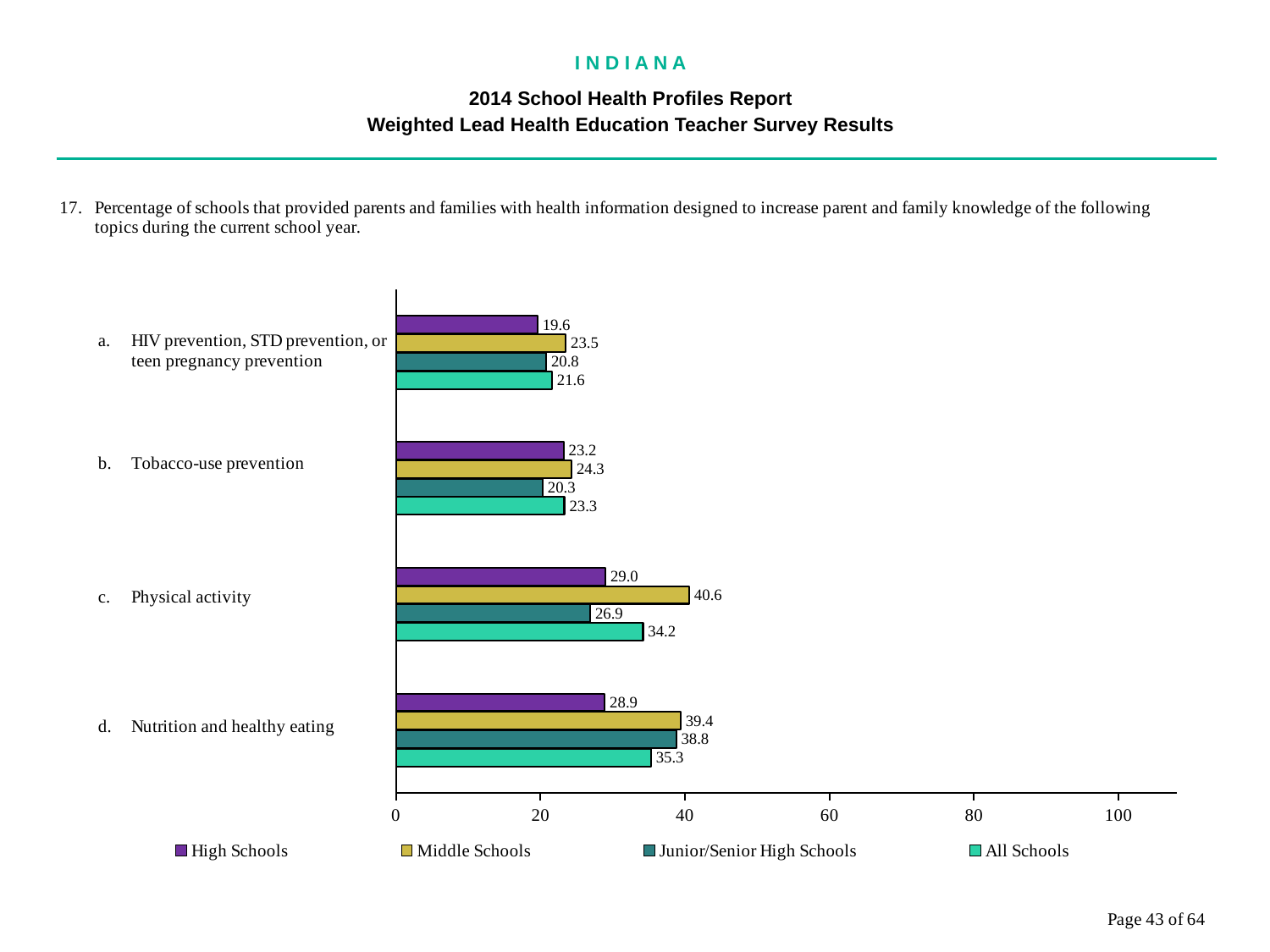
What is the value for High Schools for HIV prevention, STD prevention, or teen pregnancy prevention? 19.6 What is the difference between the Middle Schools and High Schools values for Physical activity? 11.6 What is the value for Junior/Senior High Schools for Nutrition and healthy eating? 38.8 What is the value for All Schools for Tobacco-use prevention? 23.3 How many topics (categories) are shown in the chart? 4 How many series does the legend list? 4 Is the value for Middle Schools for Physical activity greater or less than 40? greater What is the value for Middle Schools for Physical activity? 40.6 For Nutrition and healthy eating, which is larger: the Middle Schools value or the High Schools value? Middle Schools Which topic has the highest value for All Schools? Nutrition and healthy eating What kind of chart is shown on the slide? Bar chart Which topic has the lowest value for Middle Schools? HIV prevention, STD prevention, or teen pregnancy prevention